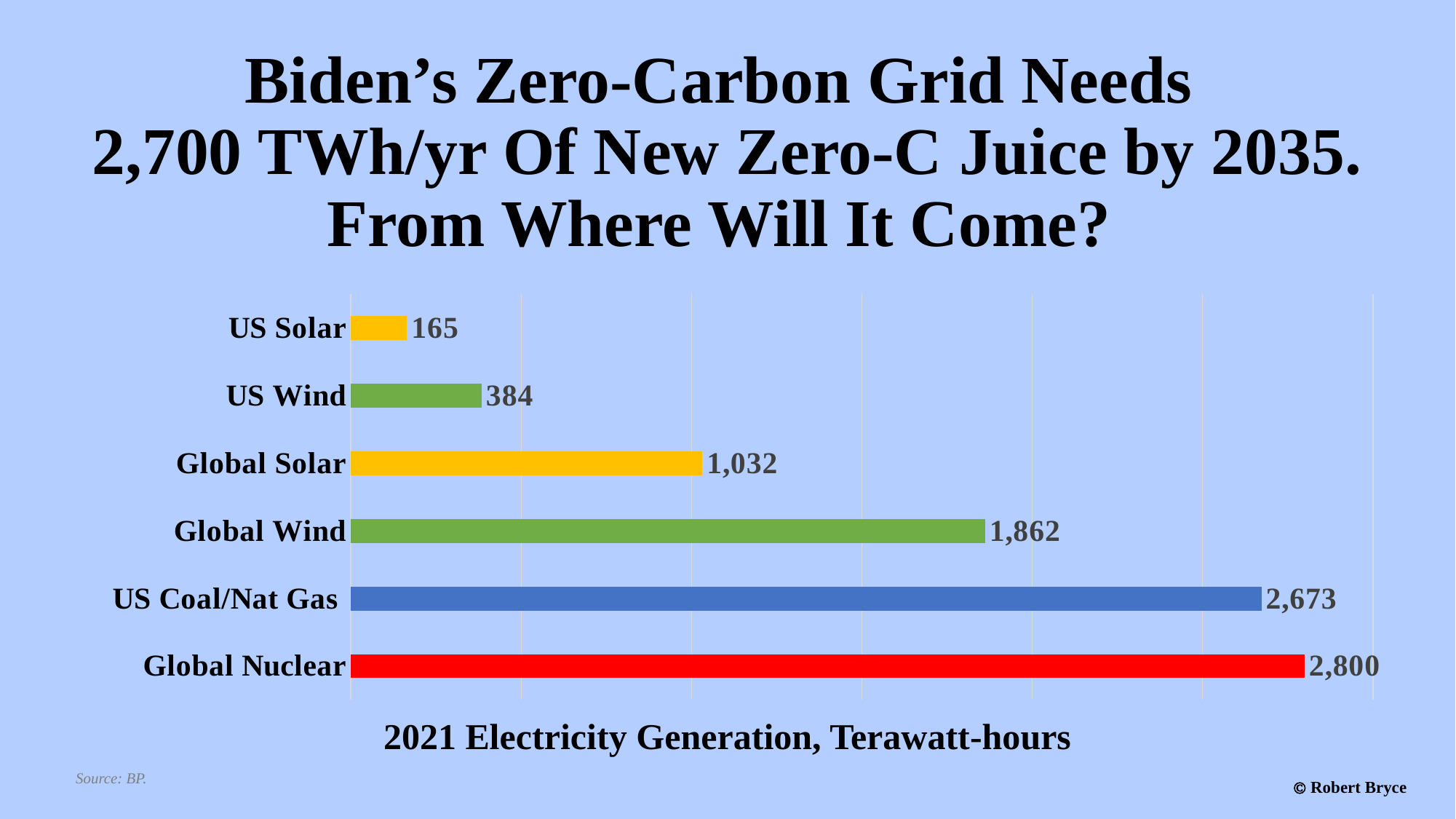
What colour is the Global Nuclear bar? Red What is the value for Global Nuclear? 2,800 What is the value for US Wind? 384 What is the difference between Global Nuclear and US Coal/Nat Gas? 127 What kind of chart is shown on the slide? Bar chart What is the difference between Global Wind and Global Solar? 830 Which is larger, US Wind or US Solar? US Wind How many categories are shown in the chart? 6 Which category has the highest value? Global Nuclear What is the value for Global Solar? 1,032 Which category has the lowest value? US Solar What is the axis label shown below the bars? 2021 Electricity Generation, Terawatt-hours